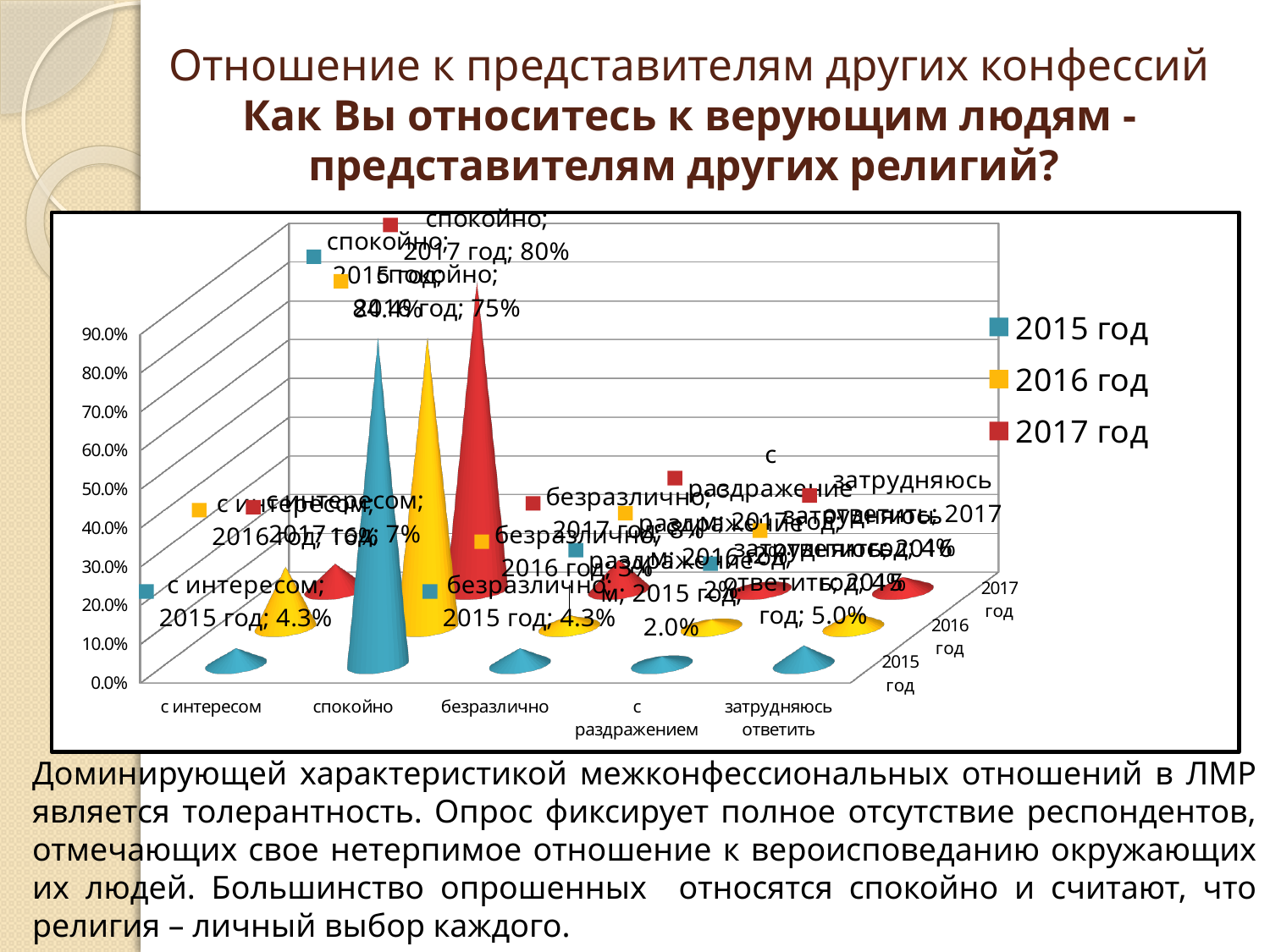
What kind of chart is shown on the slide? bar chart What is the value for 'с раздражением' in 2015 год? 2.0% How many series does the legend list? 3 Which category has the highest values across all years? спокойно What is the value for 'безразлично' in 2015 год? 4.3% What is the value for 'спокойно' in 2017 год? 80% What are the three legend entries? 2015 год, 2016 год, 2017 год Which is larger in 2017 год: 'спокойно' or 'с интересом'? спокойно How many categories are shown on the x axis? 5 Is the value for 'спокойно' in 2015 год greater or less than 80%? greater What is the value for 'затрудняюсь ответить' in 2015 год? 5.0% What is the value for 'с интересом' in 2015 год? 4.3%